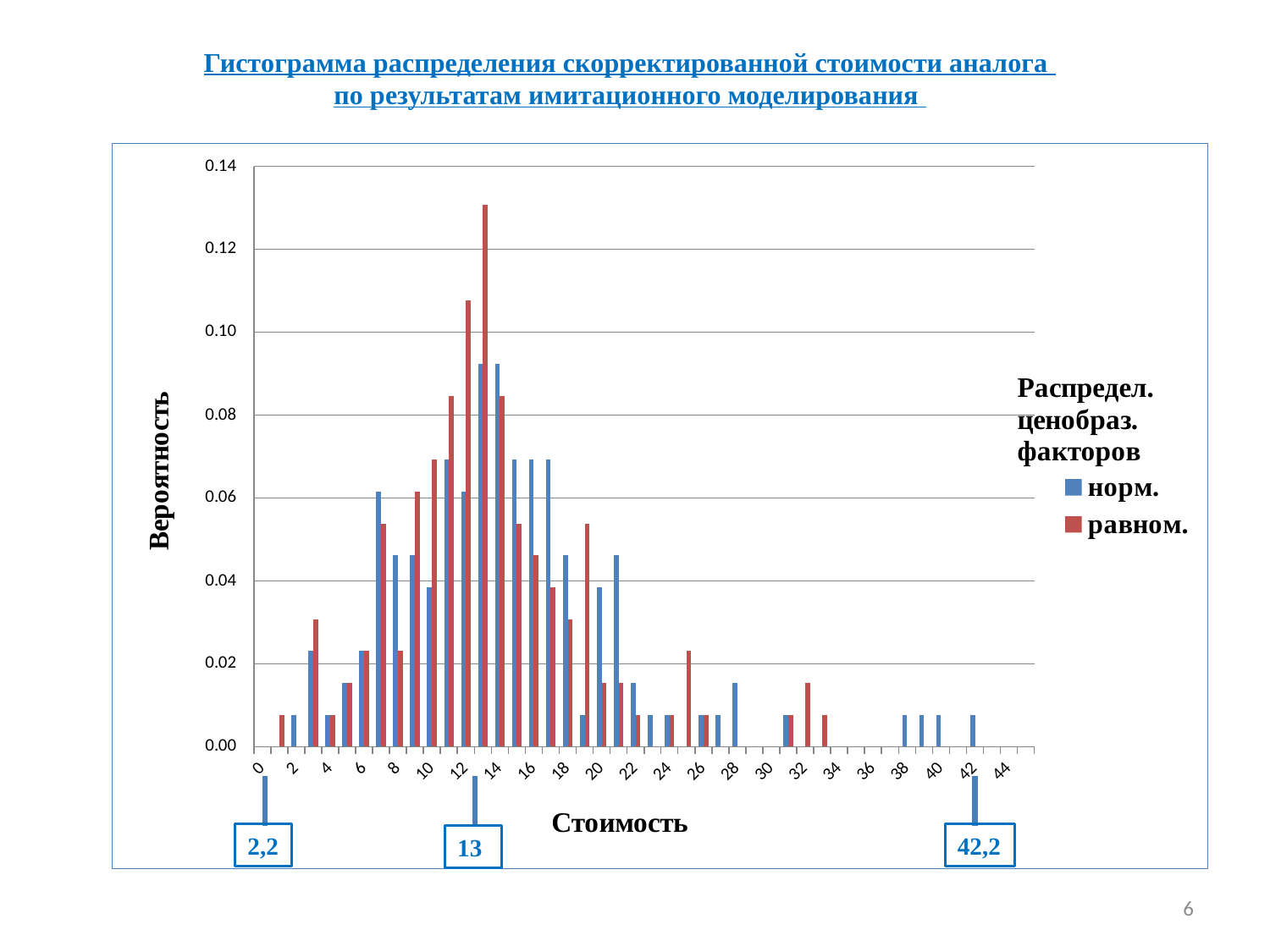
Is the value of the норм. series at x = 28 greater or less than 0.02? less What kind of chart is shown on the slide? bar chart At which x-axis value does the равном. series reach its highest bar? 13 What are the two series named in the legend? норм. and равном. At x = 13, which series has the larger value, норм. or равном.? равном. How many series does the legend list? 2 What is the title of the vertical axis? Вероятность Is the value of the норм. series at x = 13 greater or less than 0.10? less At x = 17, which series has the larger value, норм. or равном.? норм. Is the value of the равном. series at x = 12 greater or less than 0.10? greater At x = 3, which series has the larger value, норм. or равном.? равном.